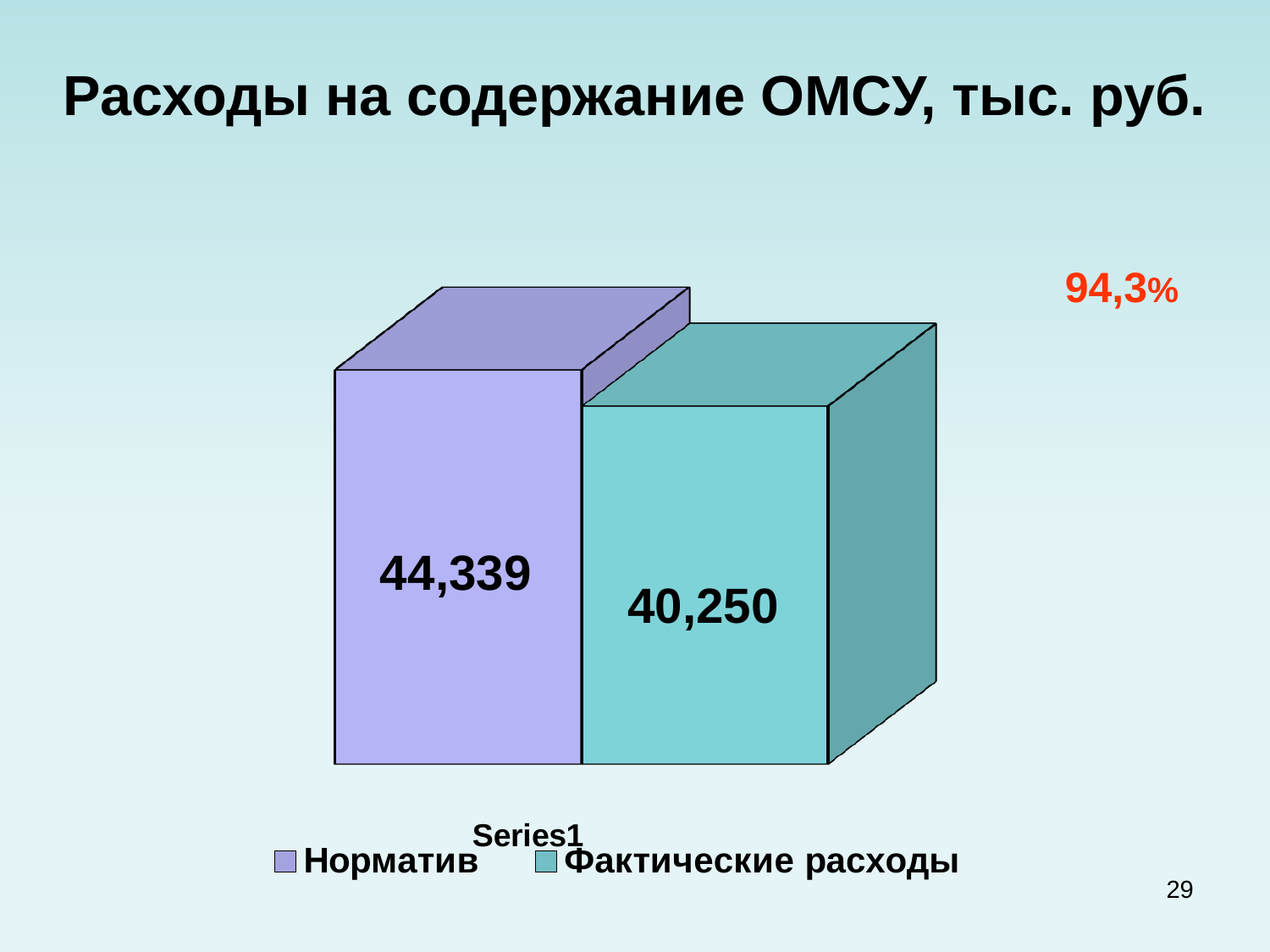
What is the category label shown below the bars? Series1 Is the value for Фактические расходы larger or smaller than the value for Норматив? smaller What is the value for Фактические расходы? 40,250 What is the difference between the Норматив value and the Фактические расходы value? 4,089 What is the title of the slide? Расходы на содержание ОМСУ, тыс. руб. What percentage is shown in red at the top right of the chart? 94,3% What is the value for Норматив? 44,339 What kind of chart is shown on the slide? bar chart How many series does the legend list? 2 Which series has the higher value, Норматив or Фактические расходы? Норматив How many bars are plotted on the chart? 2 Which series has the lower value? Фактические расходы